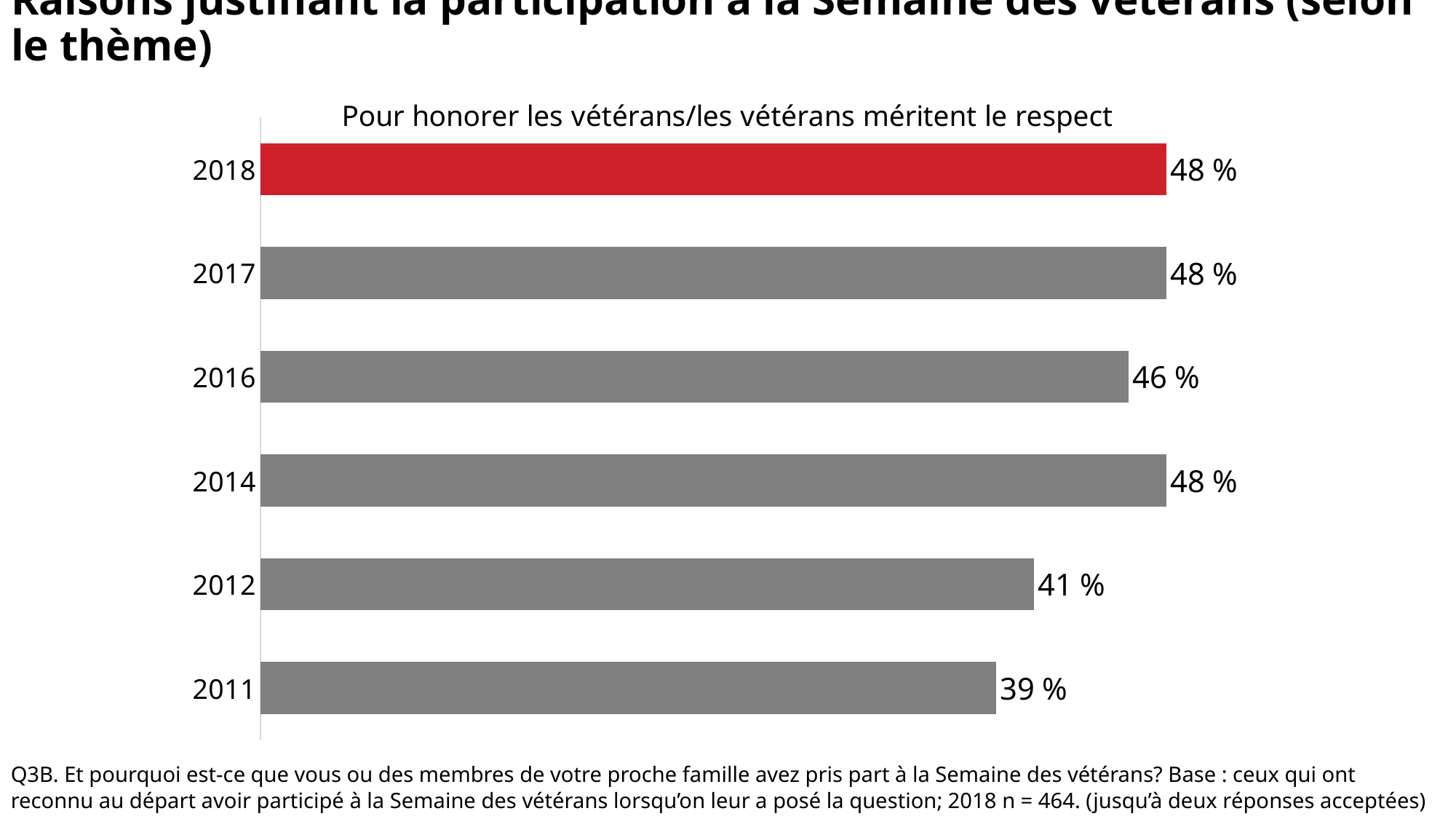
What is the value for 2018 in the chart? 48 % What is the value for 2016 in the chart? 46 % How many years are shown in the chart? 6 Which is larger, the value for 2016 or the value for 2012? 2016 What is the value for 2012 in the chart? 41 % What kind of chart is shown on the slide? Bar chart Which year has the lowest value in the chart? 2011 What is the title of the chart? Pour honorer les vétérans/les vétérans méritent le respect What is the difference between the values for 2018 and 2011? 9 % What is the difference between the values for 2016 and 2012? 5 % What is the value for 2011 in the chart? 39 % Which is larger, the value for 2014 or the value for 2011? 2014